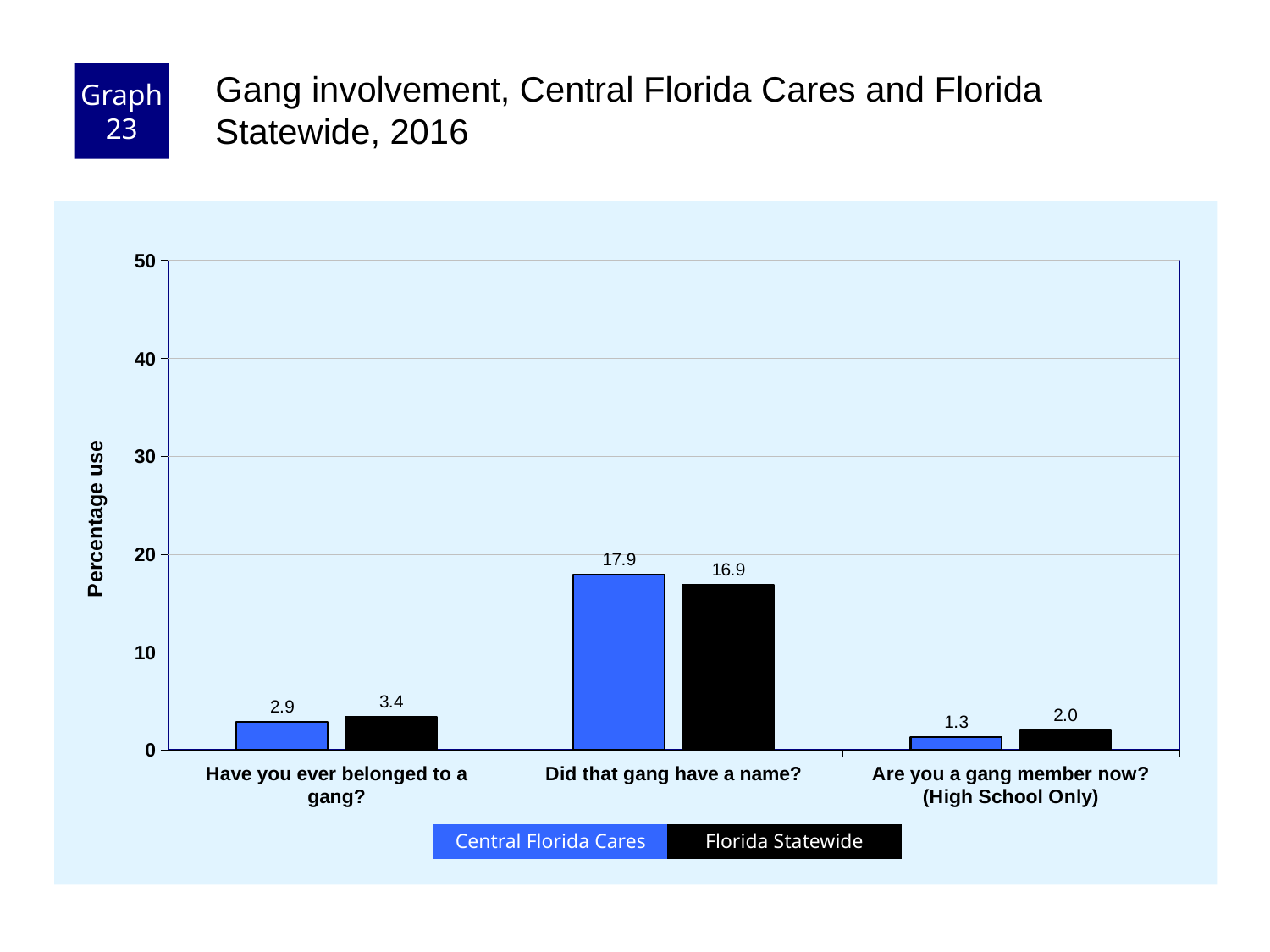
Which question has the highest Central Florida Cares value? Did that gang have a name? What is the Central Florida Cares value for "Are you a gang member now? (High School Only)"? 1.3 What kind of chart is shown? bar chart What is the difference between the Central Florida Cares and Florida Statewide values for "Did that gang have a name?"? 1.0 How many series does the legend list? 2 What is the Florida Statewide value for "Are you a gang member now? (High School Only)"? 2.0 Which question has the lowest Florida Statewide value? Are you a gang member now? (High School Only) What is the Florida Statewide value for "Have you ever belonged to a gang?"? 3.4 What is the Central Florida Cares value for "Did that gang have a name?"? 17.9 Is the Florida Statewide value for "Did that gang have a name?" greater or less than 20? less How many question categories are shown on the x axis? 3 For "Have you ever belonged to a gang?", which is larger: Central Florida Cares or Florida Statewide? Florida Statewide